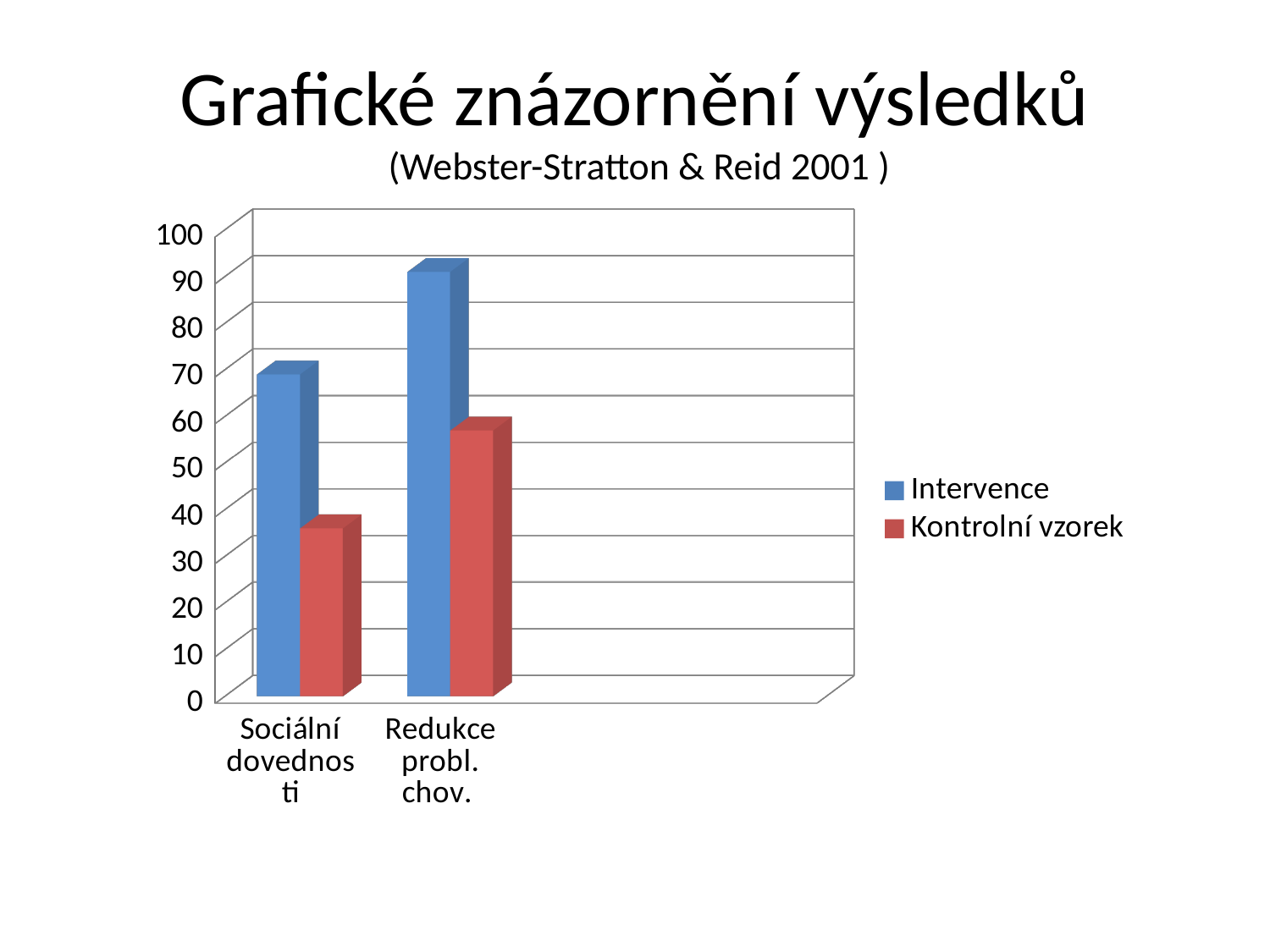
What kind of chart is shown on the slide? bar chart What is the title of the chart slide? Grafické znázornění výsledků Which series is shown in blue? Intervence For Redukce probl. chov., which series has the larger value, Intervence or Kontrolní vzorek? Intervence For which category is the Intervence value highest? Redukce probl. chov. Is the Kontrolní vzorek value for Sociální dovednosti greater or less than 50? less Is the Kontrolní vzorek value for Redukce probl. chov. greater or less than 70? less Is the Intervence value for Redukce probl. chov. greater or less than 80? greater How many categories are shown on the x axis? 2 Which bar is the lowest in the chart? Kontrolní vzorek for Sociální dovednosti How many series does the legend list? 2